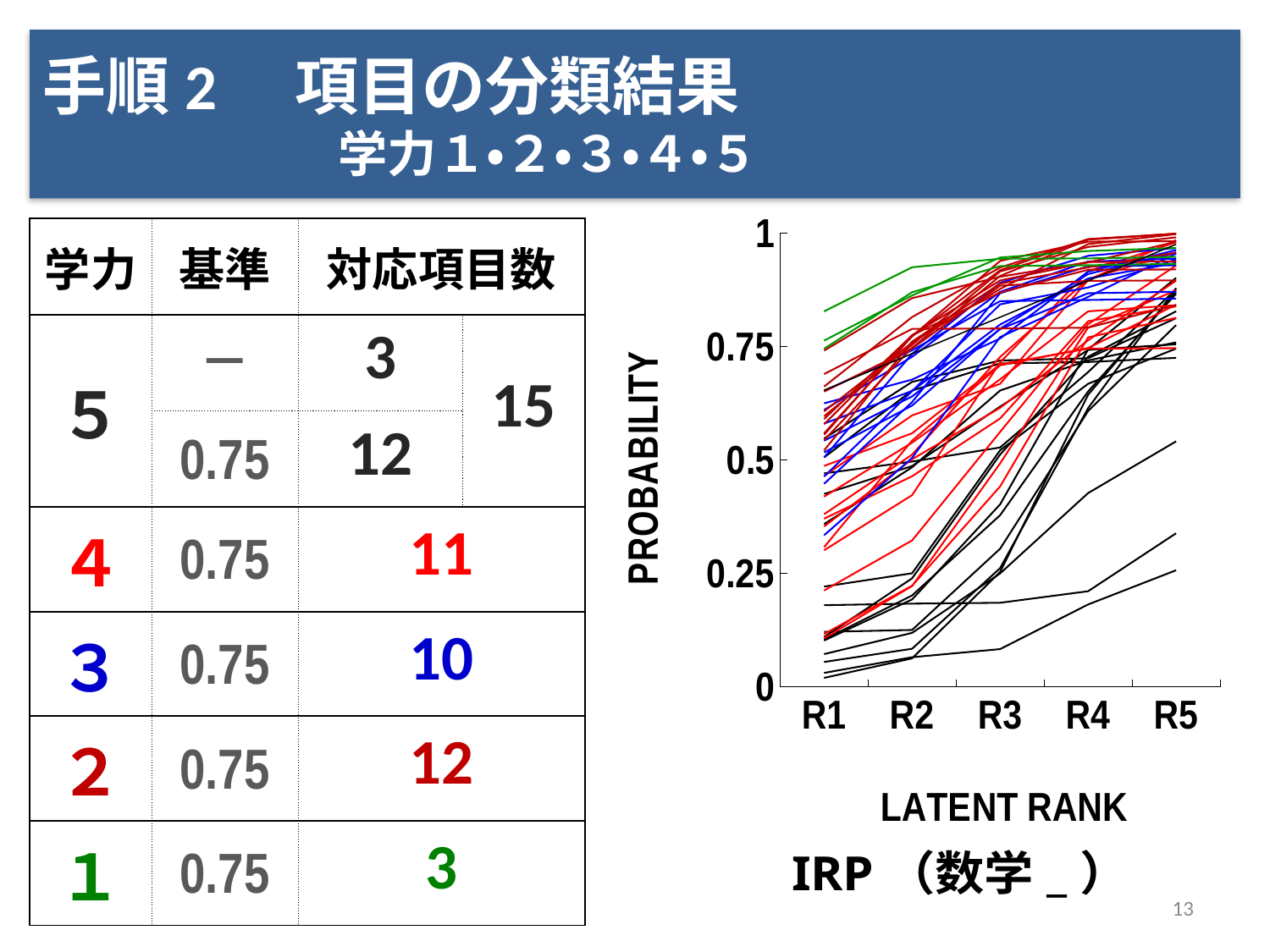
How many latent rank categories are shown on the x axis of the IRP chart? 5 What is the label of the y axis of the IRP chart? PROBABILITY What is the label of the x axis of the IRP chart? LATENT RANK What is the last category on the x axis of the IRP chart? R5 What is the first category on the x axis of the IRP chart? R1 What kind of chart is the IRP chart on the right of the slide? line chart In the IRP chart, do the plotted lines generally rise or fall from R1 to R5? rise What is the highest tick value shown on the y axis of the IRP chart? 1